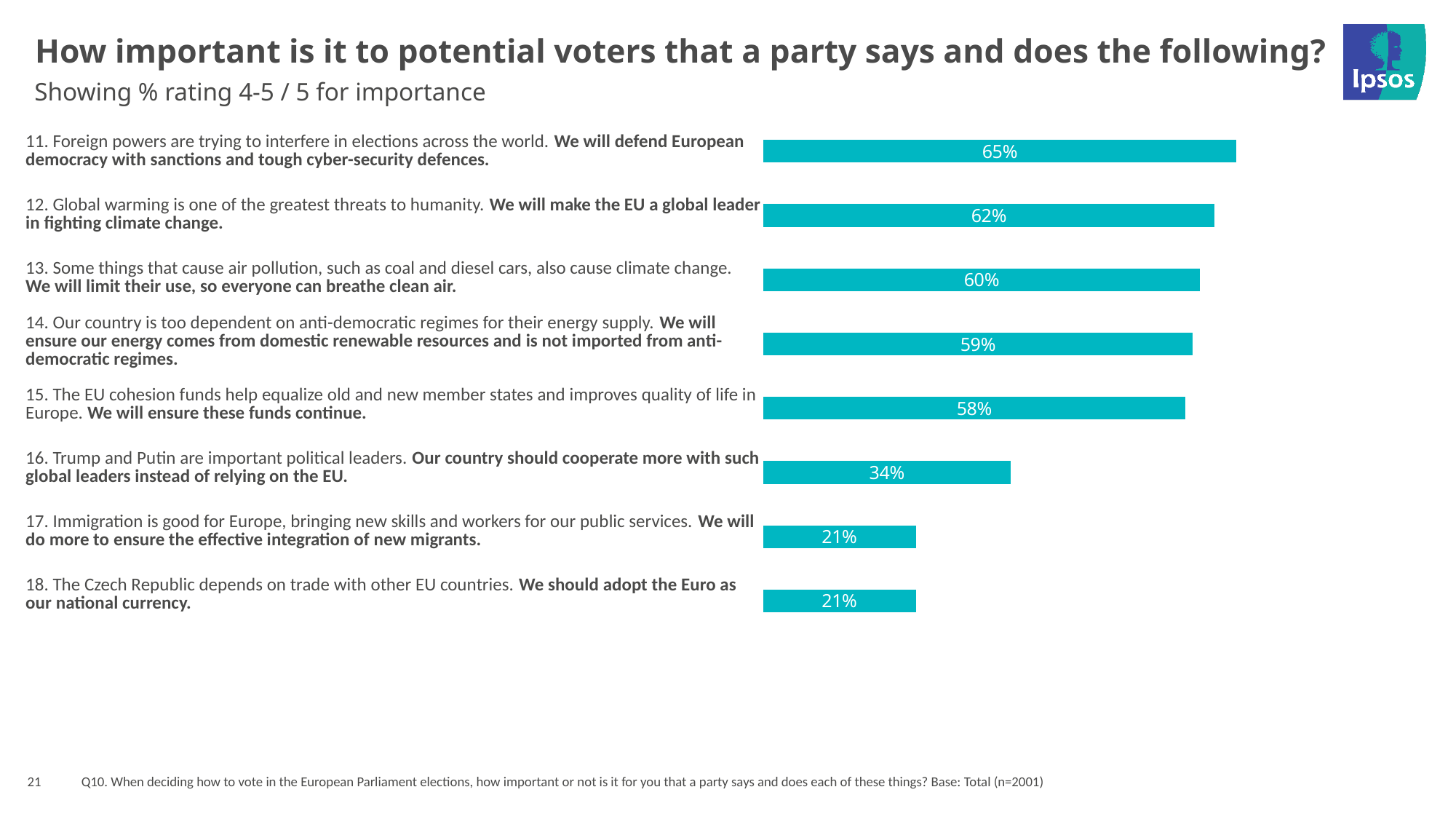
How many statements are plotted on the chart? 8 What is the difference between the values for statement 11 (65%) and statement 16 (34%)? 31 percentage points What is the difference between the values for statement 12 (climate change leadership) and statement 13 (limiting air pollution)? 2 percentage points What percentage of potential voters rated statement 11 (defending European democracy with sanctions and tough cyber-security defences) as important? 65% Which two statements share the same value of 21%? Statements 17 (integration of new migrants) and 18 (adopting the Euro) Which has a higher value: statement 14 (domestic renewable energy) or statement 17 (integration of new migrants)? Statement 14 (domestic renewable energy) What type of chart is shown on the slide? Bar chart What is the value shown for statement 16 (cooperating more with global leaders like Trump and Putin instead of relying on the EU)? 34% What percentage is shown for statement 15 (ensuring EU cohesion funds continue)? 58% Do the values rise or fall going from the top bar to the bottom bar? Fall What is the lowest value shown on the chart? 21% Which statement has the highest percentage rating 4-5 for importance? 11. Defending European democracy with sanctions and tough cyber-security defences